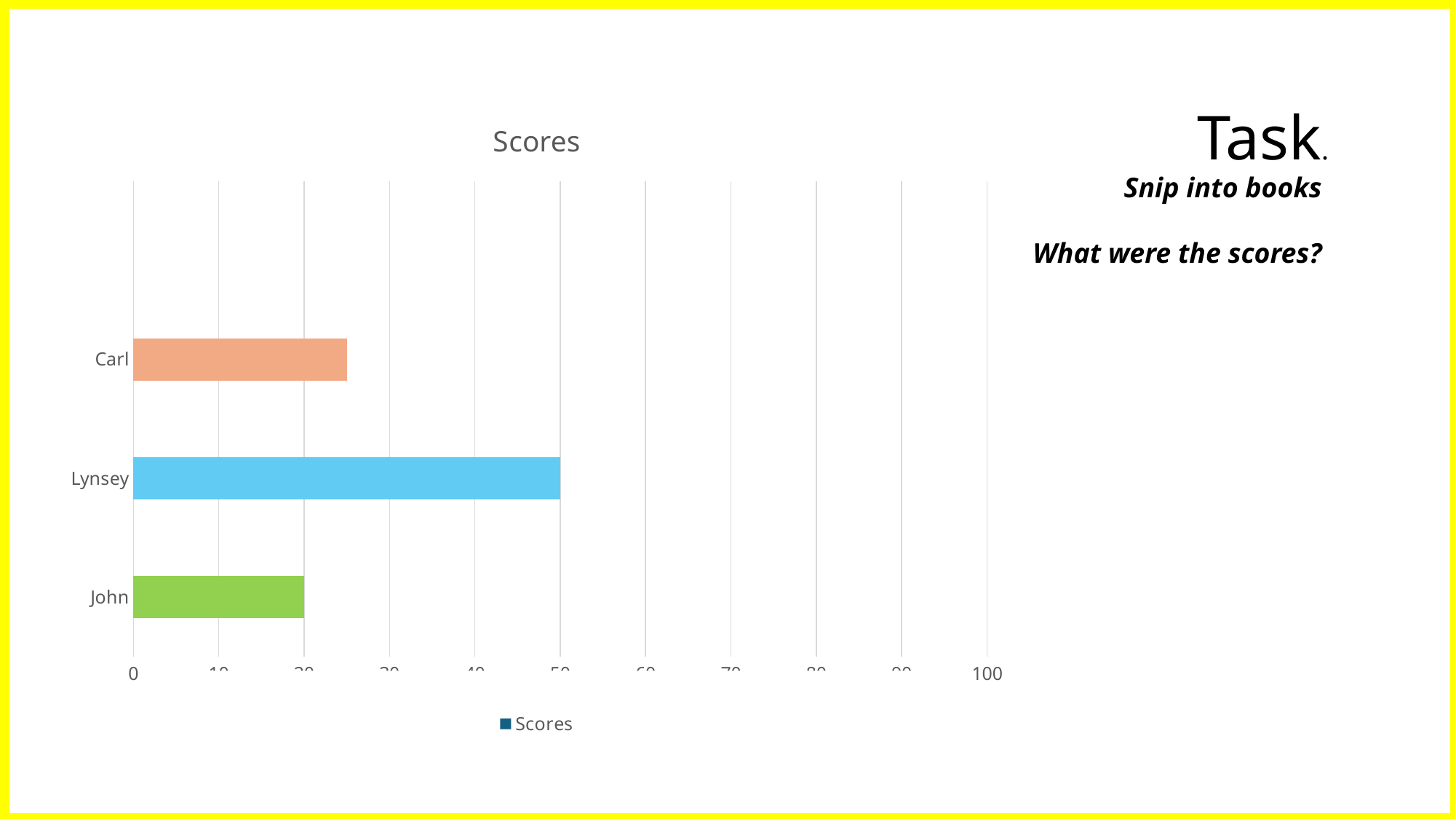
What is the score for Lynsey? 50 Who has the lowest score? John What kind of chart is shown on the slide? bar chart Who has the larger score, Carl or John? Carl How many people are shown on the chart? 3 What is the score for John? 20 Who has the highest score? Lynsey Is the score for Carl greater or less than 20? greater Is the score for Carl greater or less than 30? less What is the title of the chart? Scores How many series does the legend list? 1 What is the difference between Lynsey's score and John's score? 30